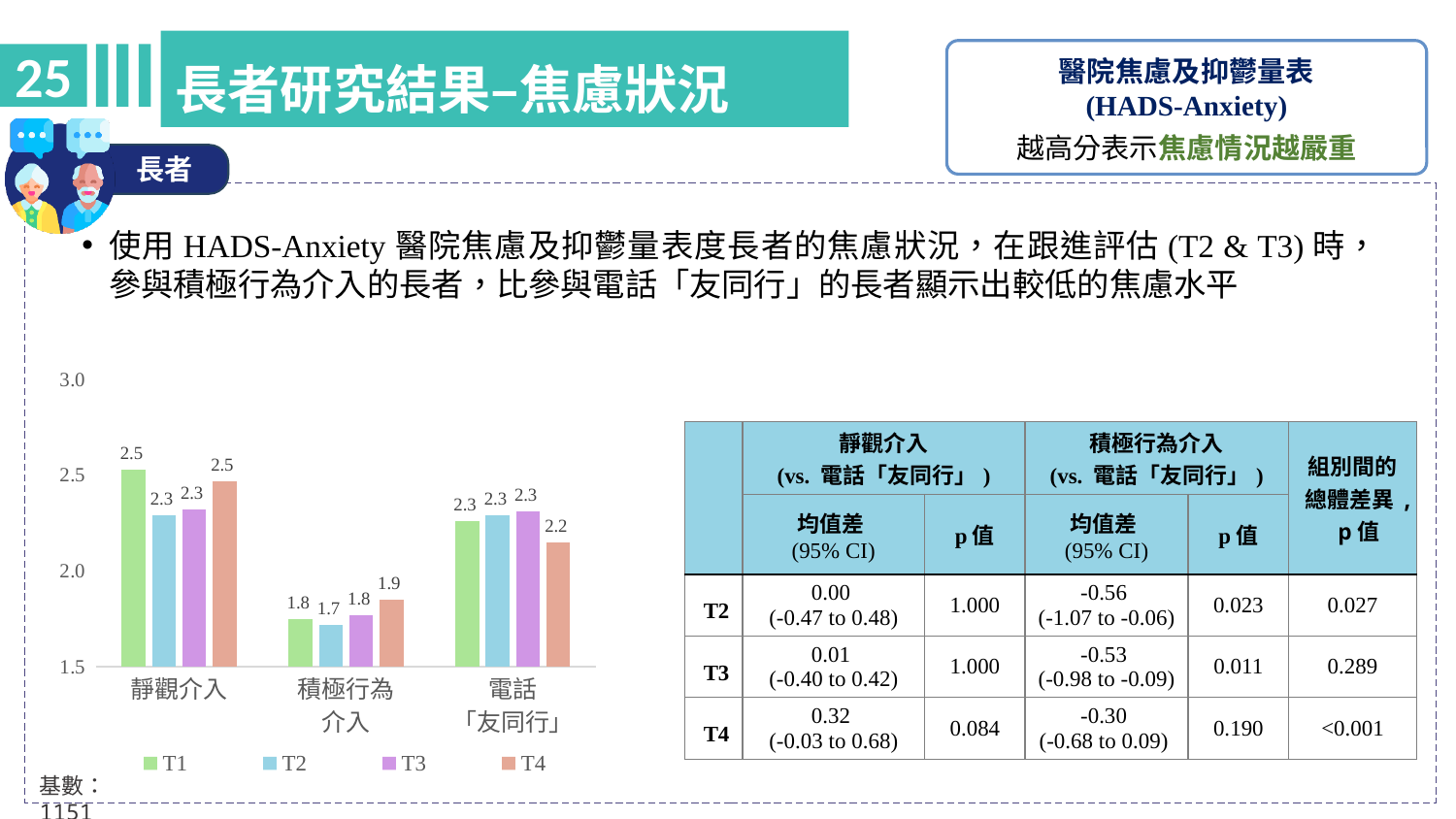
How many series does the chart legend list? 4 Within 積極行為介入, which time point has the lowest value? T2 Is the T2 value for 積極行為介入 greater or less than 2.0? less What is the T2 value for 積極行為介入? 1.7 What is the T1 value for 靜觀介入? 2.5 What is the T4 value for 電話「友同行」? 2.2 Which category has the lowest values across all time points? 積極行為介入 At T4, which is larger: 靜觀介入 or 電話「友同行」? 靜觀介入 What kind of chart is shown on the slide? bar chart How many categories are shown on the x axis of the chart? 3 What is the difference between the T1 value for 靜觀介入 and the T1 value for 積極行為介入? 0.7 What is the T3 value for 電話「友同行」? 2.3